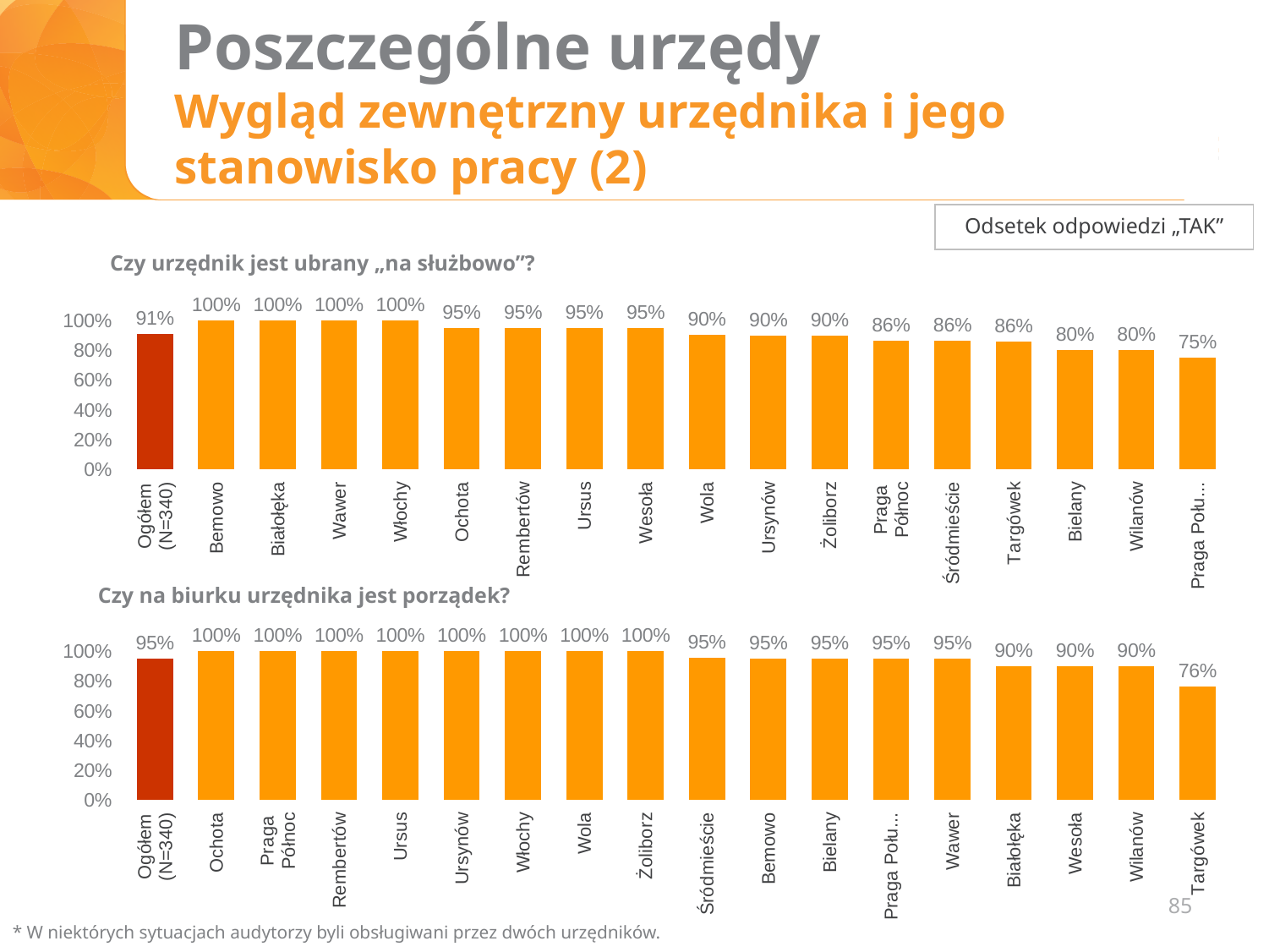
In the chart "Czy na biurku urzędnika jest porządek?", what is the difference between the values for Ogółem (N=340) and Targówek? 19% In the chart "Czy na biurku urzędnika jest porządek?", what is the value for Targówek? 76% In the chart "Czy na biurku urzędnika jest porządek?", which category has the lowest value? Targówek In the chart "Czy na biurku urzędnika jest porządek?", what is the value for Białołęka? 90% In the chart "Czy urzędnik jest ubrany „na służbowo”?", what is the value for Ogółem (N=340)? 91% In the chart "Czy urzędnik jest ubrany „na służbowo”?", what is the value for Targówek? 86% What type of chart is the chart "Czy urzędnik jest ubrany „na służbowo”?"? Bar chart In the chart "Czy urzędnik jest ubrany „na służbowo”?", what is the difference between the values for Bemowo and Bielany? 20% In the chart "Czy urzędnik jest ubrany „na służbowo”?", which is larger, the value for Ochota or the value for Wola? Ochota In the chart "Czy na biurku urzędnika jest porządek?", how many categories are shown on the x axis? 18 In the chart "Czy urzędnik jest ubrany „na służbowo”?", do the values rise or fall from Bemowo to Praga Połu... along the x axis? Fall In the chart "Czy urzędnik jest ubrany „na służbowo”?", what is the value for Wilanów? 80%